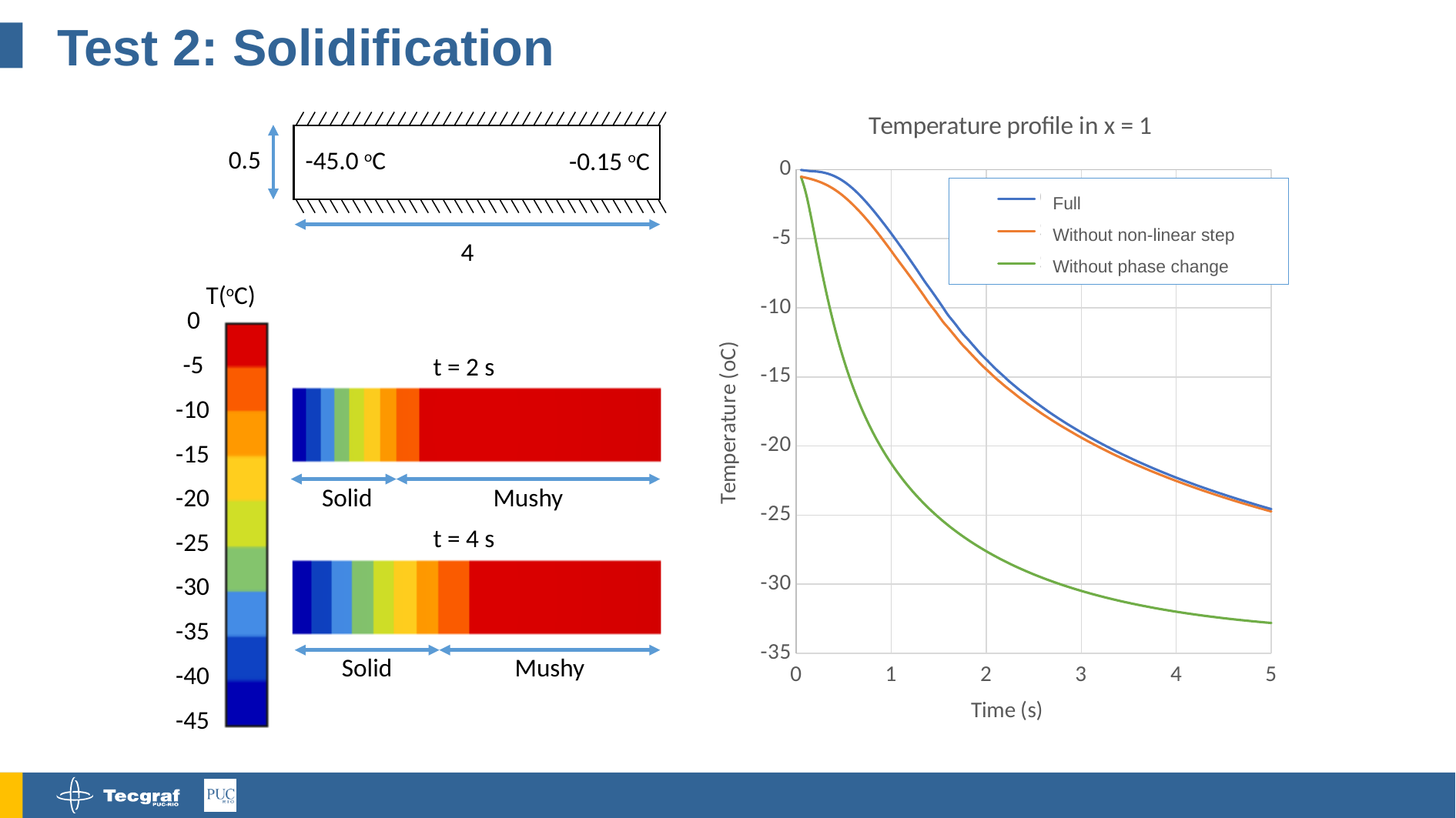
How many series does the legend of the "Temperature profile in x = 1" chart list? 3 In the "Temperature profile in x = 1" chart, is the value of Without phase change at time 2 s greater or less than -20? less In the "Temperature profile in x = 1" chart, which series has the lowest temperature at time 2 s? Without phase change In the "Temperature profile in x = 1" chart, which series has the lowest temperature at time 5 s? Without phase change In the "Temperature profile in x = 1" chart, at time 1 s, which is higher: Full or Without phase change? Full In the "Temperature profile in x = 1" chart, is the value of Full at time 2 s greater or less than -10? less In the "Temperature profile in x = 1" chart, is the value of Without phase change at time 5 s greater or less than -30? less What is the x-axis label of the "Temperature profile in x = 1" chart? Time (s) In the "Temperature profile in x = 1" chart, which series is drawn in green? Without phase change What kind of chart is "Temperature profile in x = 1"? line chart In the "Temperature profile in x = 1" chart, does the Full series rise or fall as time increases? fall